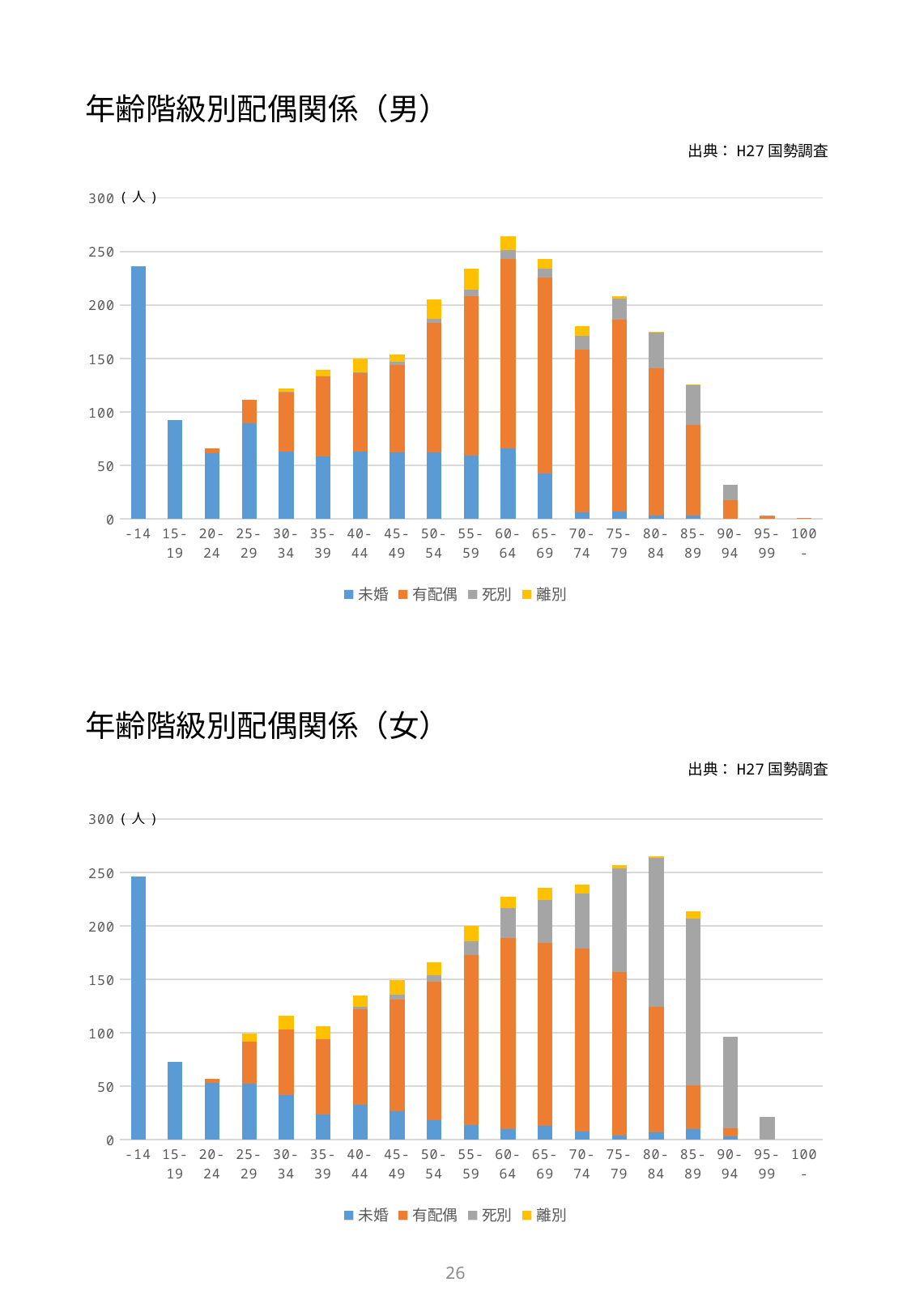
In the 年齢階級別配偶関係（女） chart, is the total for 95-99 greater or less than 50? less What are the four legend entries of the 年齢階級別配偶関係（男） chart? 未婚, 有配偶, 死別, 離別 In the 年齢階級別配偶関係（男） chart, which stacked bar is taller, -14 or 15-19? -14 In the 年齢階級別配偶関係（男） chart, is the total for -14 greater or less than 200? greater How many series does the legend of the 年齢階級別配偶関係（女） chart list? 4 In the 年齢階級別配偶関係（男） chart, is the total for 85-89 greater or less than 100? greater In the 年齢階級別配偶関係（女） chart, which stacked bar is taller, 75-79 or 20-24? 75-79 What kind of chart is the 年齢階級別配偶関係（男） chart? stacked bar chart In the 年齢階級別配偶関係（男） chart, which age category has the tallest stacked bar? 60-64 How many age categories are shown on the x axis of the 年齢階級別配偶関係（男） chart? 19